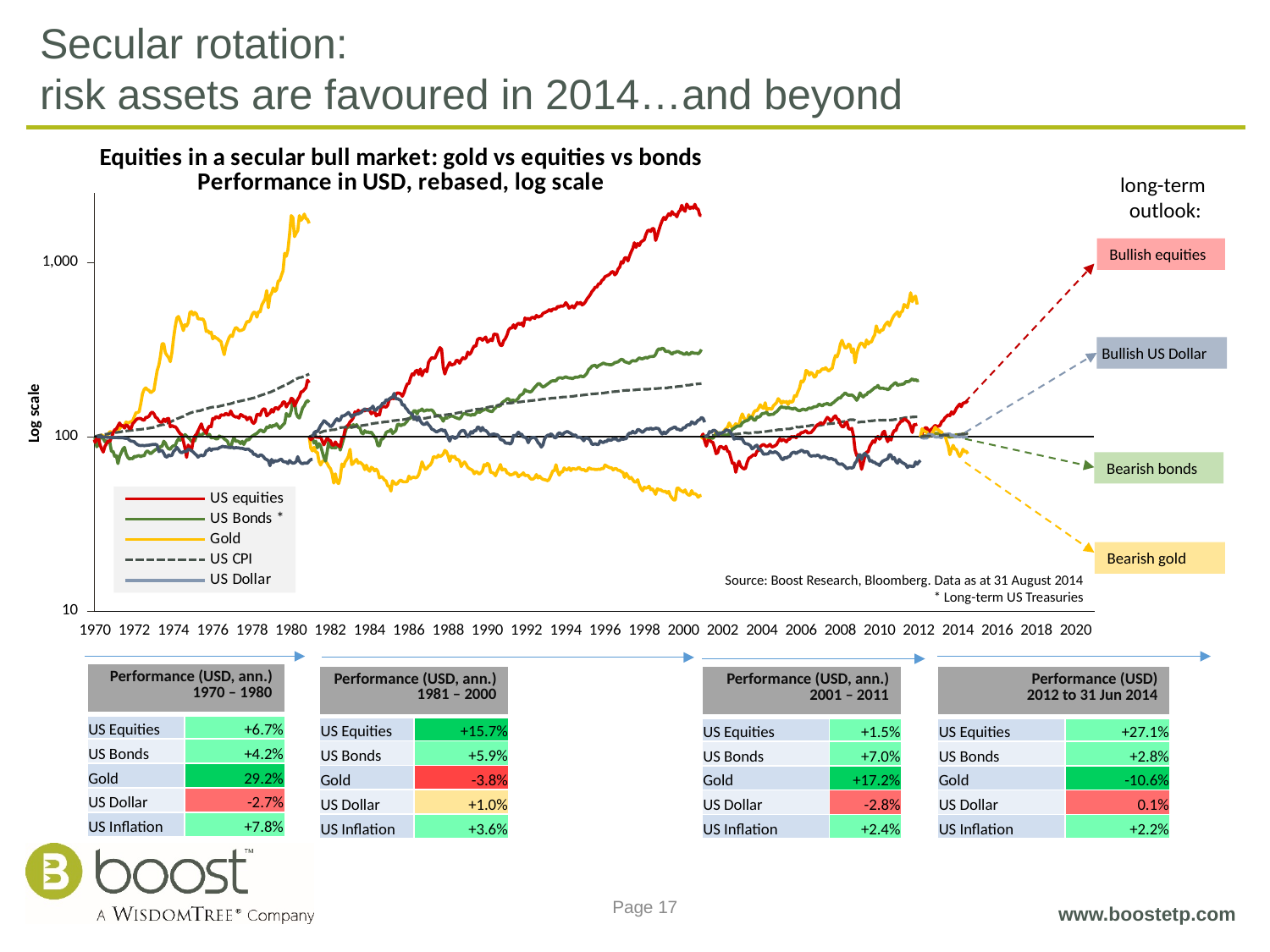
What kind of chart is shown on the slide? Line chart How many series does the chart's legend list? 5 Which series reaches the highest level in the 1970–1980 segment of the chart? Gold In the Performance (USD, ann.) 1981 – 2000 table, what is the difference between US Equities and US Bonds? 9.8 percentage points Is the value of US equities at its peak around 2000 greater or less than 1,000? greater In the Performance (USD) 2012 to 31 Jun 2014 table, what is the value for US Equities? +27.1% What is the title of the chart? Equities in a secular bull market: gold vs equities vs bonds Performance in USD, rebased, log scale Does the US equities line rise or fall between 1981 and 2000? Rise In the Performance (USD, ann.) 1970 – 1980 table, which asset has the highest value? Gold Is the value of Gold at its peak around 1980 greater or less than 1,000? greater Is the value of Gold around 2000 greater or less than 100? less Which series are listed in the chart's legend? US equities, US Bonds *, Gold, US CPI, US Dollar